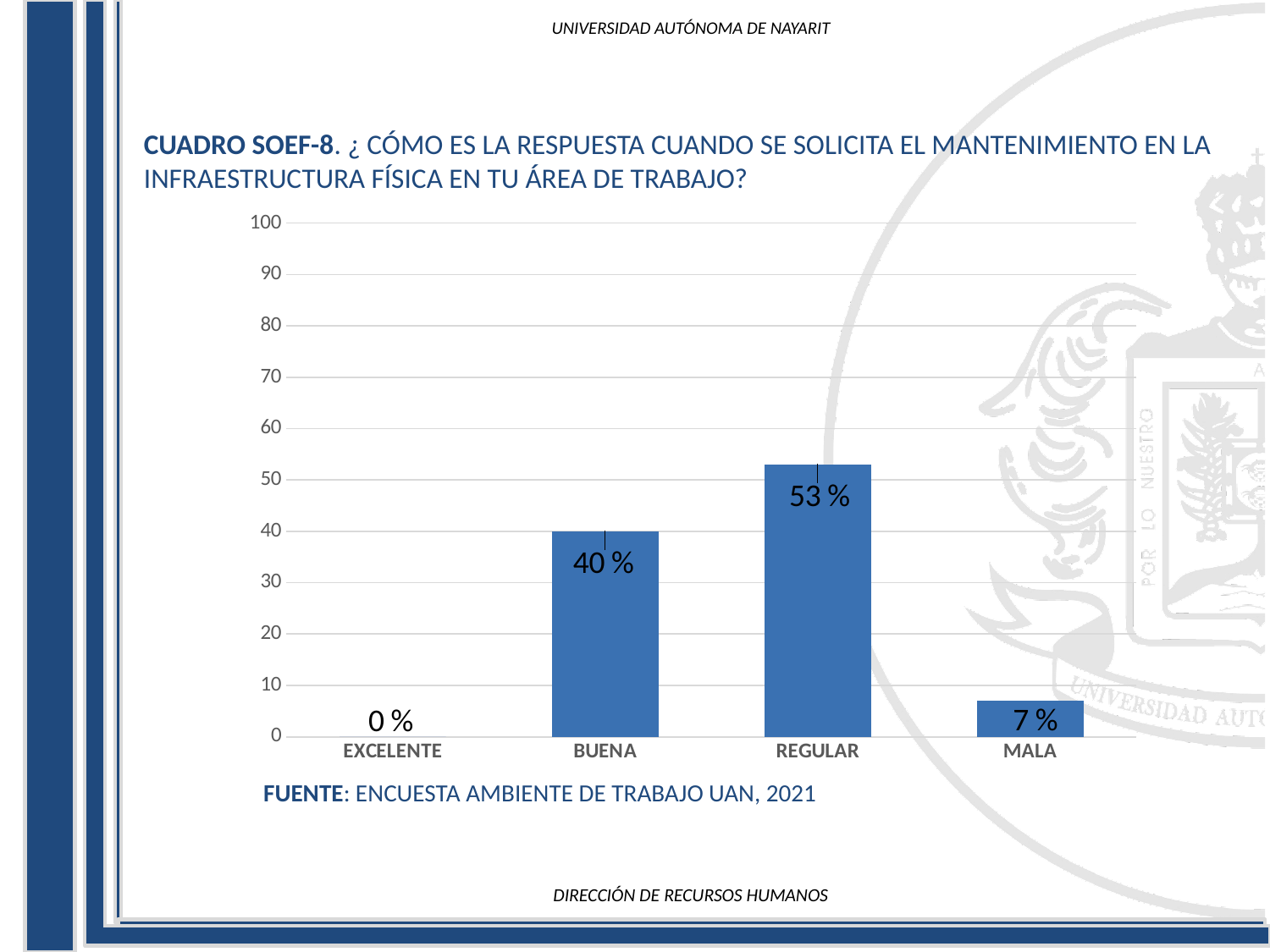
What is the value for EXCELENTE? 0 % How many categories are shown on the x axis? 4 What source is cited below the chart? ENCUESTA AMBIENTE DE TRABAJO UAN, 2021 Which category has the highest value? REGULAR What kind of chart is shown on the slide? bar chart Is the value for REGULAR greater or less than 50? greater What is the value for MALA? 7 % What is the difference between the values for REGULAR and BUENA? 13 % What is the value for REGULAR? 53 % What is the value for BUENA? 40 % Which is larger, the value for BUENA or the value for MALA? BUENA Which category has the lowest value? EXCELENTE